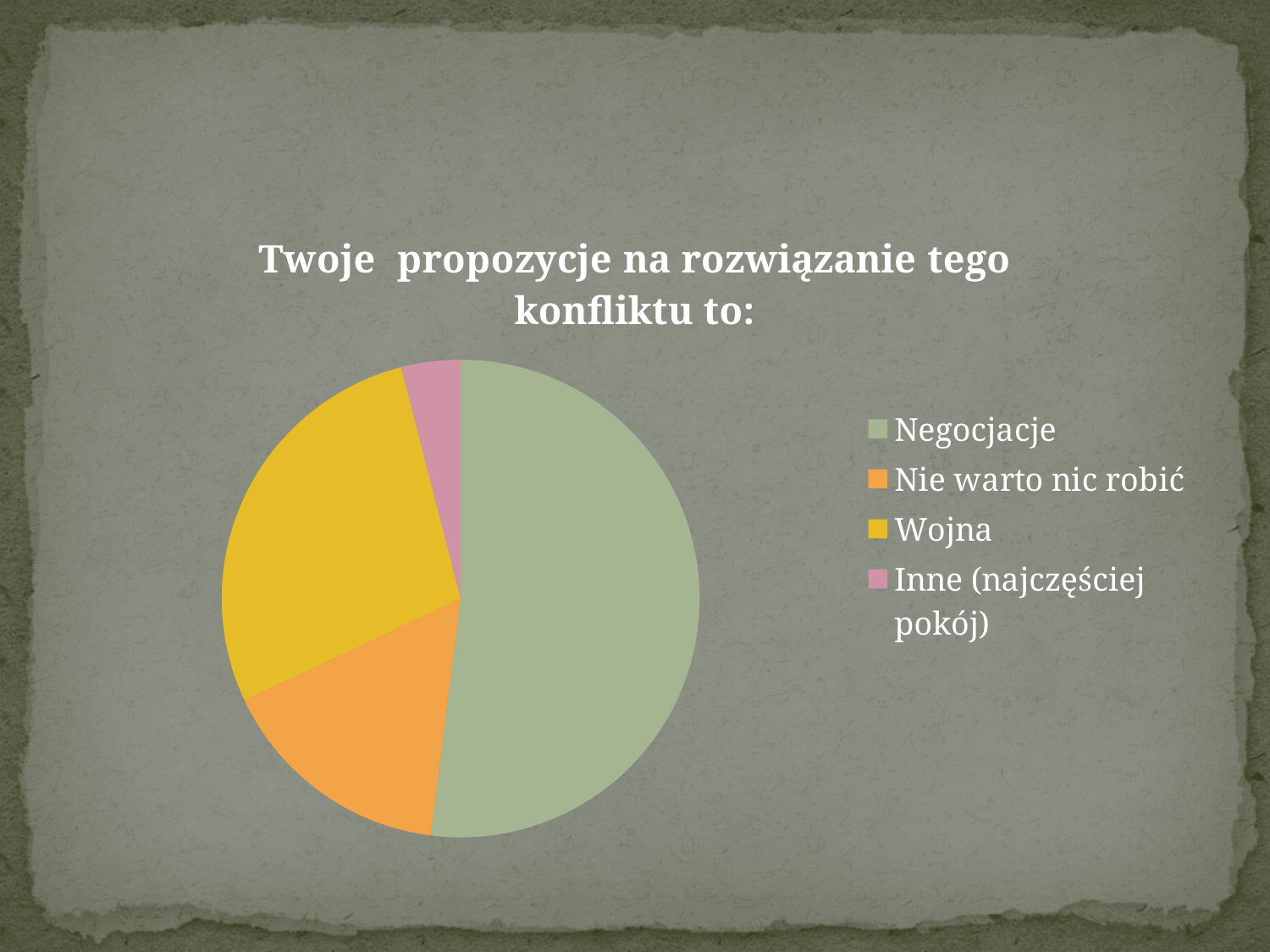
Which slice is larger, Wojna or Nie warto nic robić? Wojna What is the title of the chart? Twoje propozycje na rozwiązanie tego konfliktu to: Which slice is larger, Nie warto nic robić or Inne (najczęściej pokój)? Nie warto nic robić What colour is the Wojna slice in the pie chart? yellow How many slices does the pie chart have? 4 Which category has the smallest slice of the pie? Inne (najczęściej pokój) What kind of chart is shown on the slide? pie chart Which category has the largest slice of the pie? Negocjacje How many entries does the legend list? 4 Which slice is larger, Negocjacje or Wojna? Negocjacje